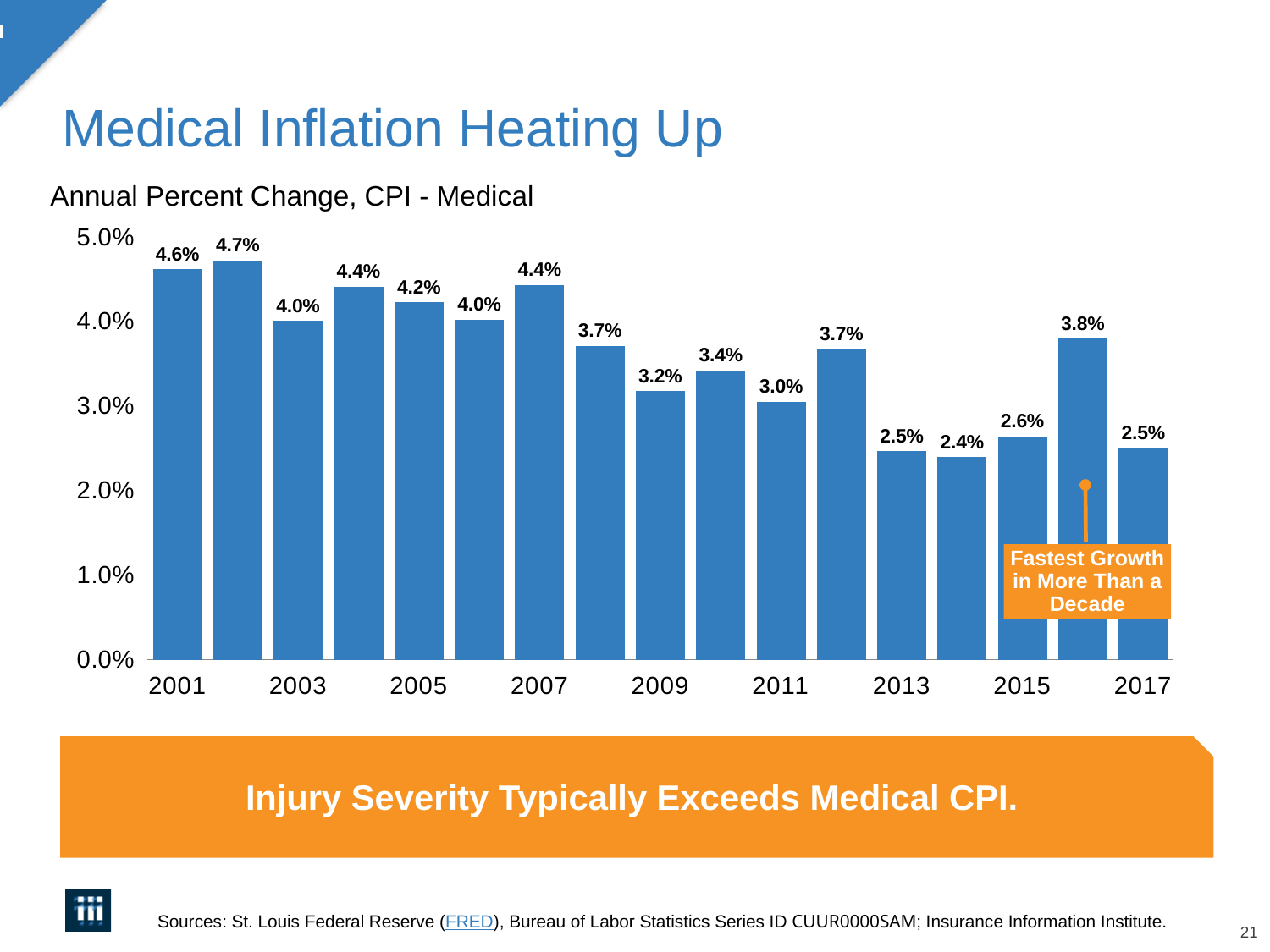
Which year has a larger value, 2009 or 2013? 2009 What value is shown for the bar marked with the 'Fastest Growth in More Than a Decade' callout? 3.8% Which year has the lowest annual percent change on the chart? 2014 What is the value shown for 2017? 2.5% What is the annual percent change in CPI - Medical for 2001? 4.6% Which year has the highest annual percent change on the chart? 2002 What is the difference between the values for 2001 and 2017? 2.1% Is the value for 2015 greater or less than 3.0%? less What is the subtitle describing the data plotted on the chart? Annual Percent Change, CPI - Medical How many bars are plotted on the chart? 17 What is the value shown for 2011? 3.0% What kind of chart is shown on the slide? Bar chart